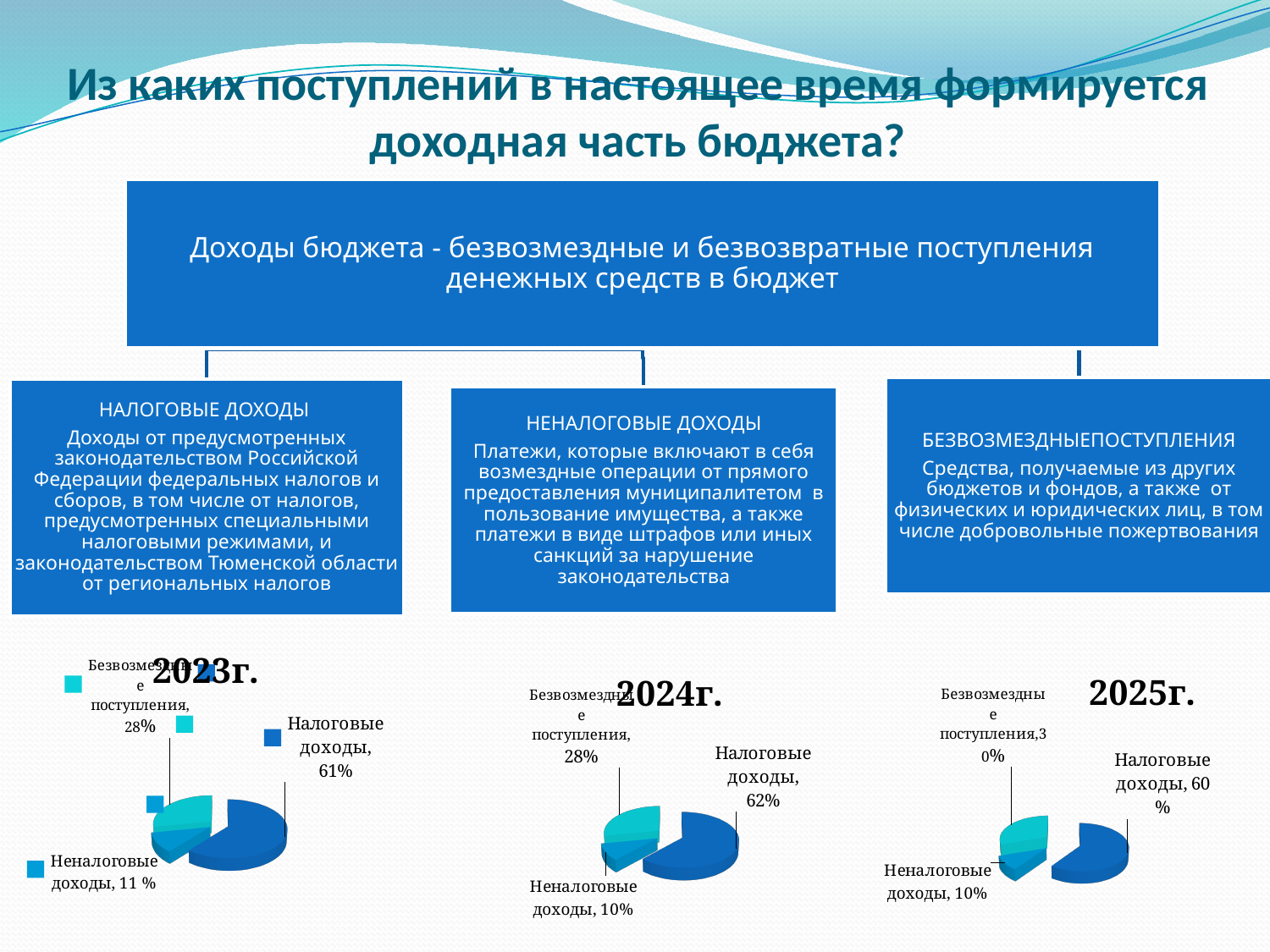
In the 2024г. pie chart, what is the share of Неналоговые доходы? 10% In the 2024г. pie chart, what is the share of Налоговые доходы? 62% How many slices does each pie chart have? 3 In the 2024г. pie chart, which category has the smallest slice? Неналоговые доходы What kind of charts are shown at the bottom of the slide? Pie charts In the 2024г. pie chart, what is the difference between the shares of Налоговые доходы and Безвозмездные поступления? 34% In the 2023г. pie chart, what is the share of Безвозмездные поступления? 28% In the 2025г. pie chart, which category has the largest slice? Налоговые доходы In the 2023г. pie chart, what is the share of Неналоговые доходы? 11 % In the 2023г. pie chart, what is the share of Налоговые доходы? 61% How many pie charts are on the slide? 3 In the 2025г. pie chart, what is the share of Налоговые доходы? 60 %